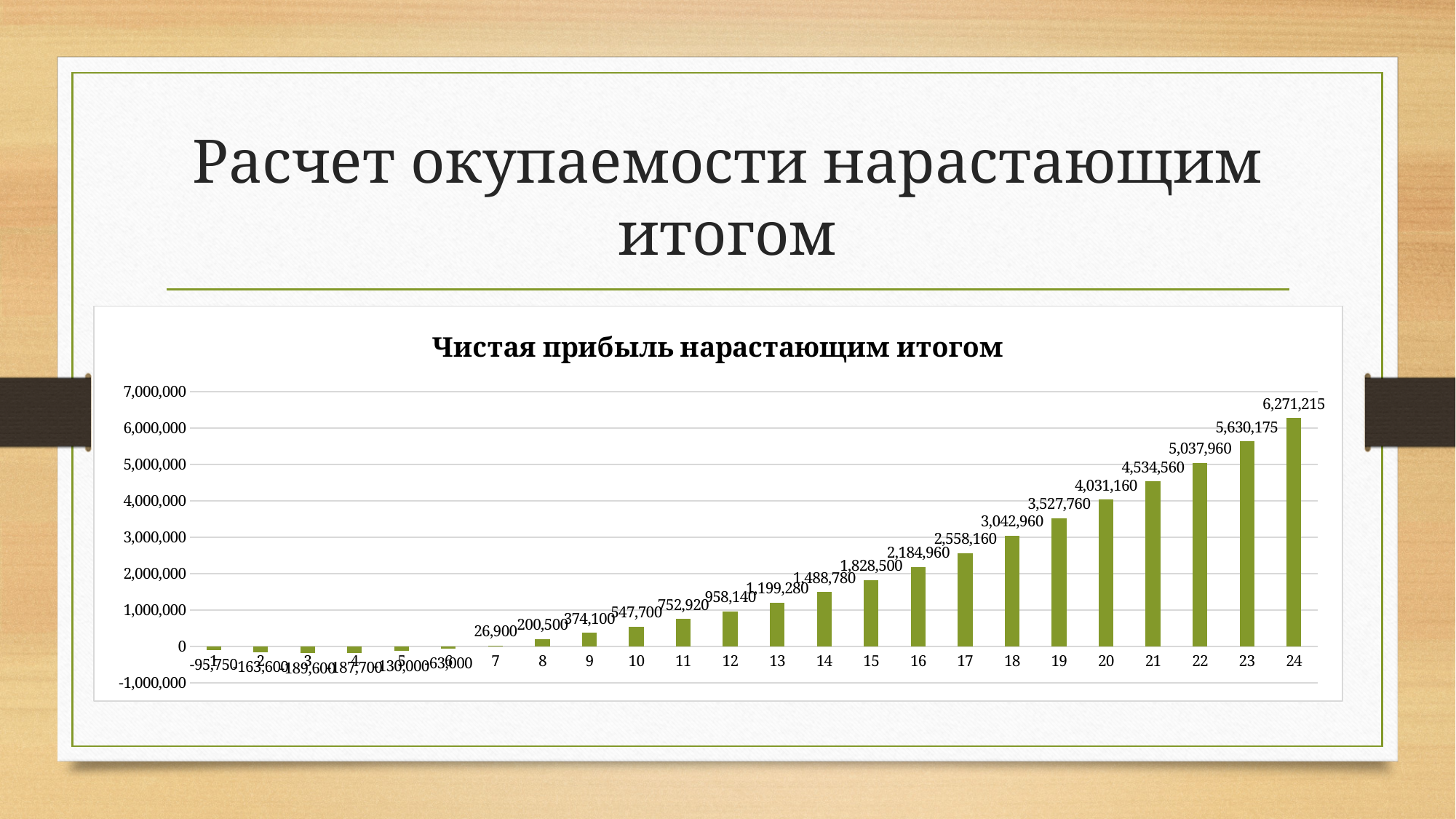
What type of chart is shown on the slide? bar chart What is the cumulative net profit value for period 24? 6,271,215 Which period has the highest cumulative net profit? 24 Which is larger, the value for period 15 or the value for period 16? period 16 Is the value for period 20 greater or less than 4,000,000? greater What is the value shown for period 7? 26,900 What is the value shown for period 12? 958,140 What is the difference between the values for period 24 and period 23? 641,040 What is the title of the chart? Чистая прибыль нарастающим итогом How many periods (bars) are plotted on the x axis? 24 What is the value shown for period 18? 3,042,960 Do the values generally rise or fall from period 7 to period 24? rise